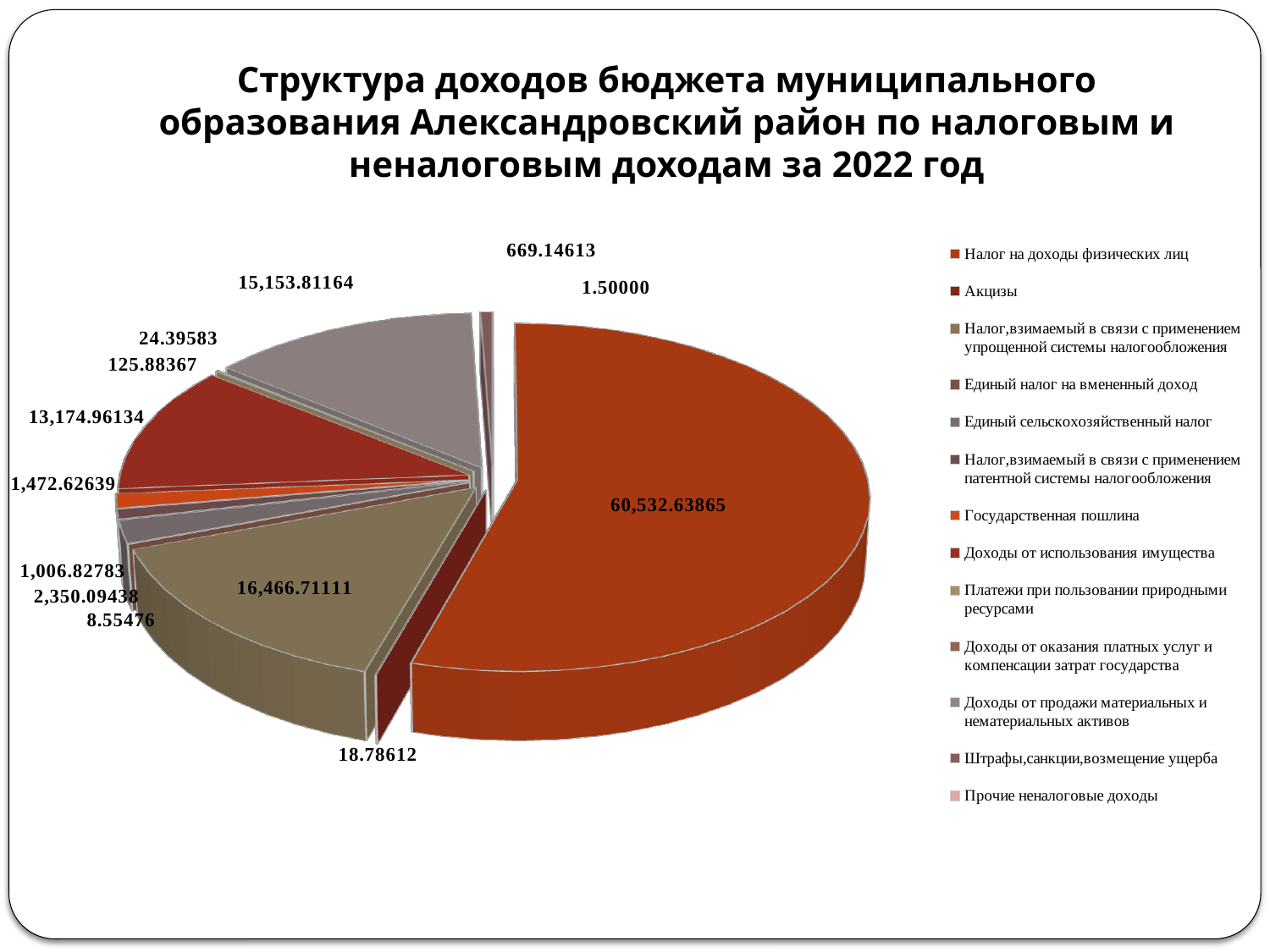
Which category has the largest slice of the pie? Налог на доходы физических лиц What is the value shown for Доходы от продажи материальных и нематериальных активов? 15,153.81164 What is the difference between the value for Налог на доходы физических лиц and the value for Налог, взимаемый в связи с применением упрощенной системы налогообложения? 44,065.92754 What is the value shown for Налог, взимаемый в связи с применением упрощенной системы налогообложения? 16,466.71111 Which is larger: the value for Налог, взимаемый в связи с применением упрощенной системы налогообложения or the value for Доходы от продажи материальных и нематериальных активов? Налог, взимаемый в связи с применением упрощенной системы налогообложения What year does the chart title say the data is for? 2022 How many categories does the legend list? 13 What is the value shown for Доходы от использования имущества? 13,174.96134 What is the value shown for Налог на доходы физических лиц? 60,532.63865 What is the value shown for Прочие неналоговые доходы? 1.50000 Which category has the smallest value in the pie chart? Прочие неналоговые доходы What kind of chart is shown on the slide? Pie chart